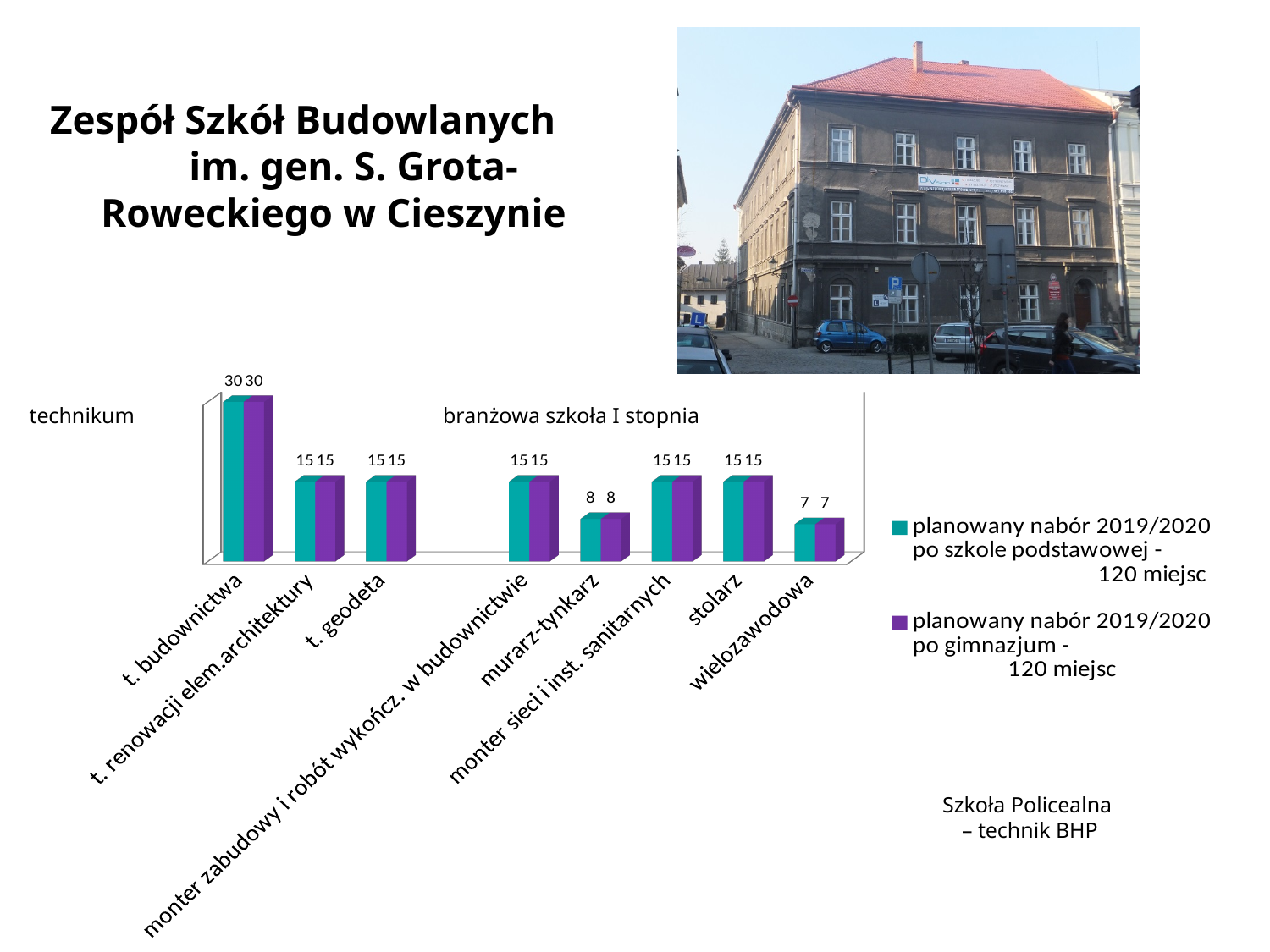
How many categories are shown on the x axis of the chart? 8 What is the planned intake after primary school (po szkole podstawowej) for t. budownictwa? 30 What is the difference between the planned intake after primary school for t. budownictwa and for t. geodeta? 15 Which category has the highest planned intake after primary school? t. budownictwa What kind of chart is shown on the slide? bar chart Which category has the lowest planned intake after gimnazjum? wielozawodowa Which has a larger planned intake after gimnazjum: murarz-tynkarz or wielozawodowa? murarz-tynkarz How many series does the chart legend list? 2 What is the planned intake after gimnazjum for stolarz? 15 What colour are the bars for the series 'planowany nabór 2019/2020 po gimnazjum - 120 miejsc'? purple What is the planned intake after primary school for wielozawodowa? 7 What is the planned intake after gimnazjum for murarz-tynkarz? 8